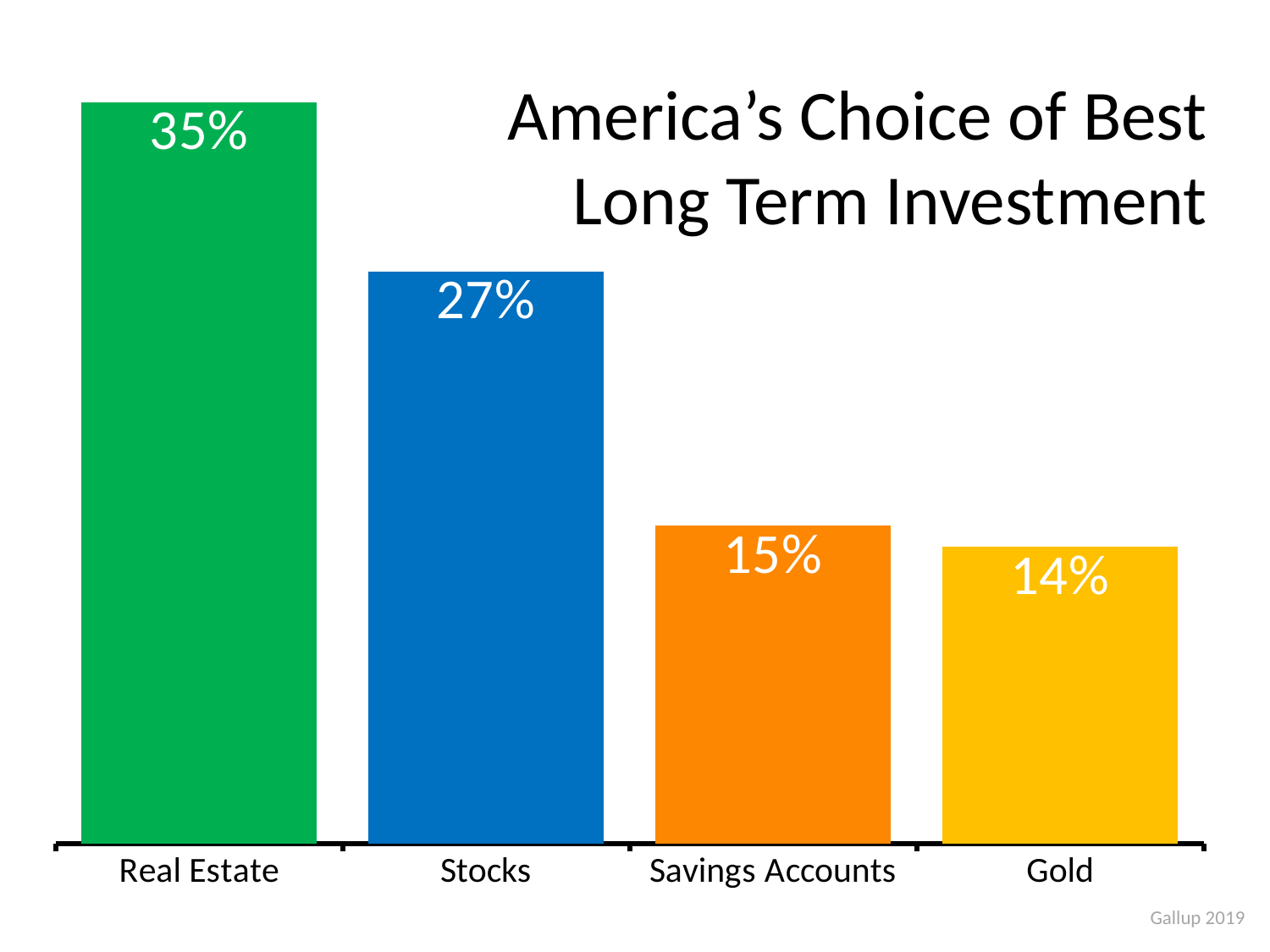
What is the difference between the values for Real Estate and Stocks? 8% Which category has the highest value? Real Estate How many categories are shown in the chart? 4 Which is larger, the value for Stocks or the value for Gold? Stocks Which category has the lowest value? Gold What is the difference between the values for Stocks and Savings Accounts? 12% What is the value shown for Gold? 14% What kind of chart is shown on the slide? Bar chart What is the value shown for Savings Accounts? 15% What is the value shown for Stocks? 27% What is the title of the chart? America's Choice of Best Long Term Investment What percentage of Americans chose Real Estate as the best long term investment? 35%